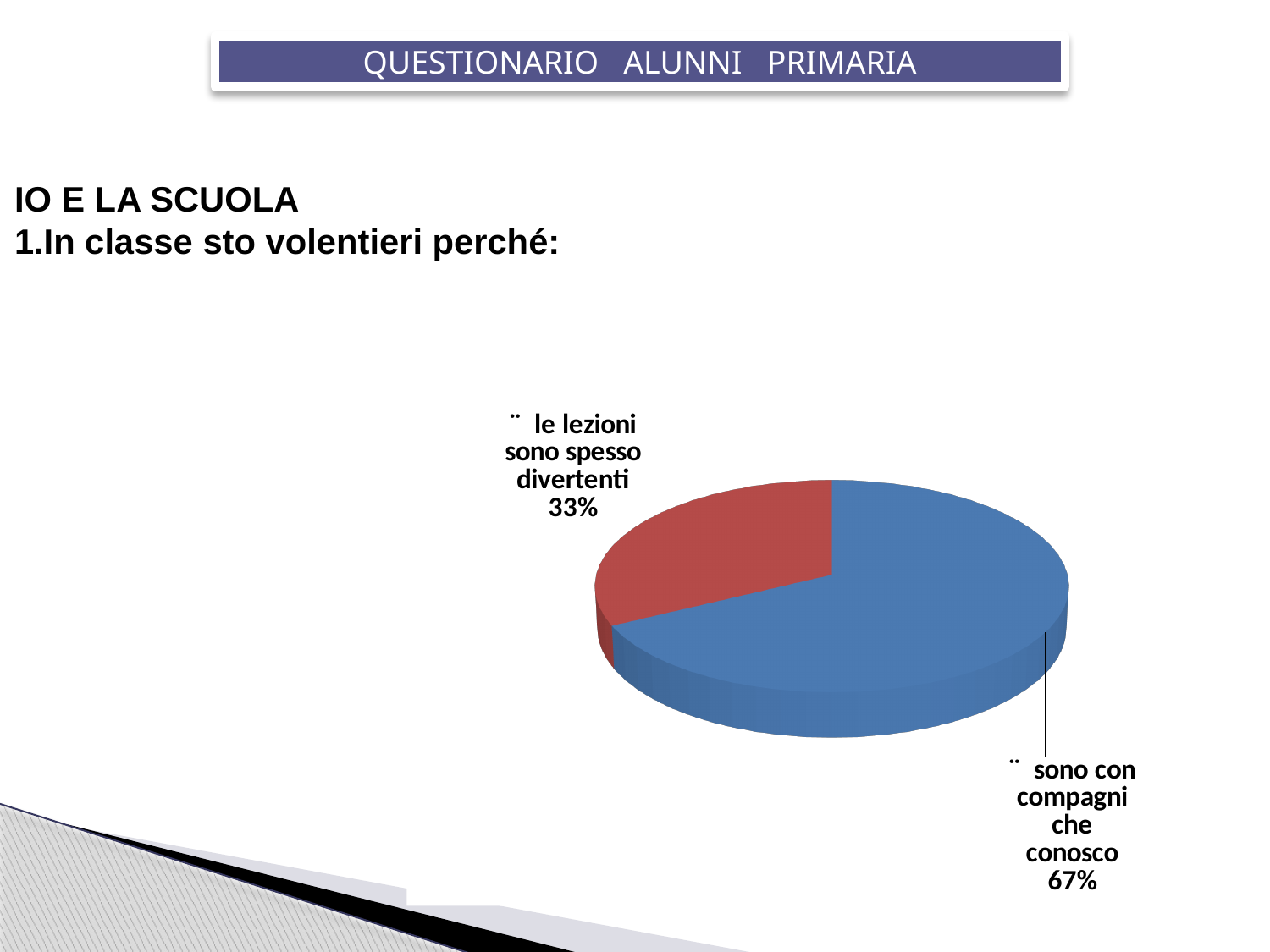
Is the share for "le lezioni sono spesso divertenti" greater or less than 50%? less What is the difference in percentage points between the "sono con compagni che conosco" slice and the "le lezioni sono spesso divertenti" slice? 34 What share of the pie does "sono con compagni che conosco" represent? 67% What colour is the slice for "sono con compagni che conosco"? blue Which slice is the largest in the pie chart? sono con compagni che conosco How many slices does the pie chart have? 2 Which is larger: the share for "le lezioni sono spesso divertenti" or the share for "sono con compagni che conosco"? sono con compagni che conosco What share of the pie does "le lezioni sono spesso divertenti" represent? 33% Which slice is the smallest in the pie chart? le lezioni sono spesso divertenti What kind of chart is shown on the slide? pie chart What colour is the slice for "le lezioni sono spesso divertenti"? red